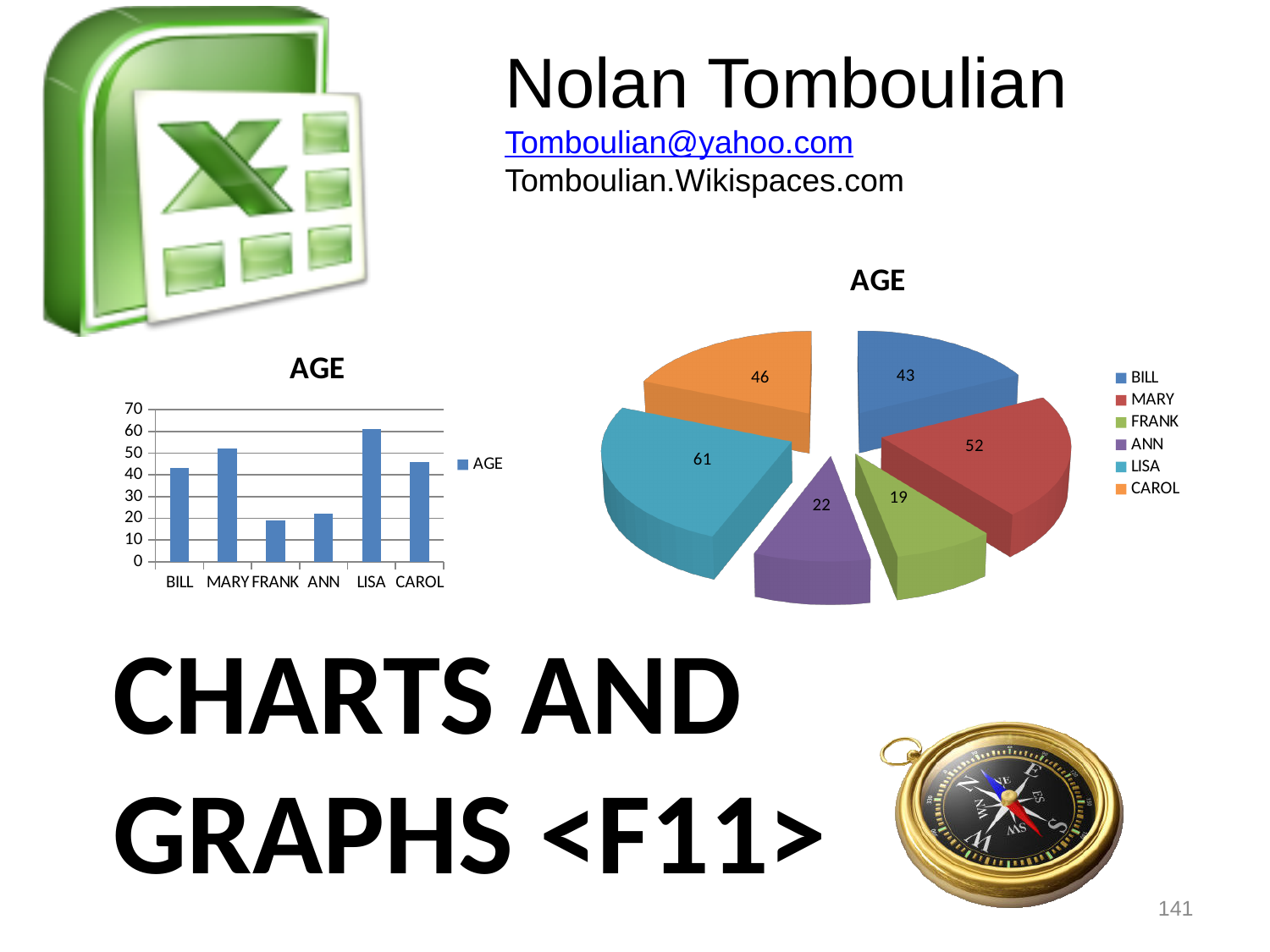
In the pie chart on the right, what is the difference between MARY's value and BILL's value? 9 What kind of chart is the chart on the right? Pie chart In the pie chart on the right, which person has the smallest slice? FRANK In the bar chart on the left, which is larger, the value for MARY or the value for CAROL? MARY In the pie chart on the right, what is the value for CAROL? 46 What kind of chart is the chart on the left? Bar chart In the pie chart on the right, what is the value for FRANK? 19 In the bar chart on the left, is the value for LISA greater or less than 50? greater In the bar chart on the left, is the value for ANN greater or less than 30? less In the pie chart on the right, what is the value for LISA? 61 In the pie chart on the right, how many slices are there? 6 In the pie chart on the right, which person has the largest slice? LISA